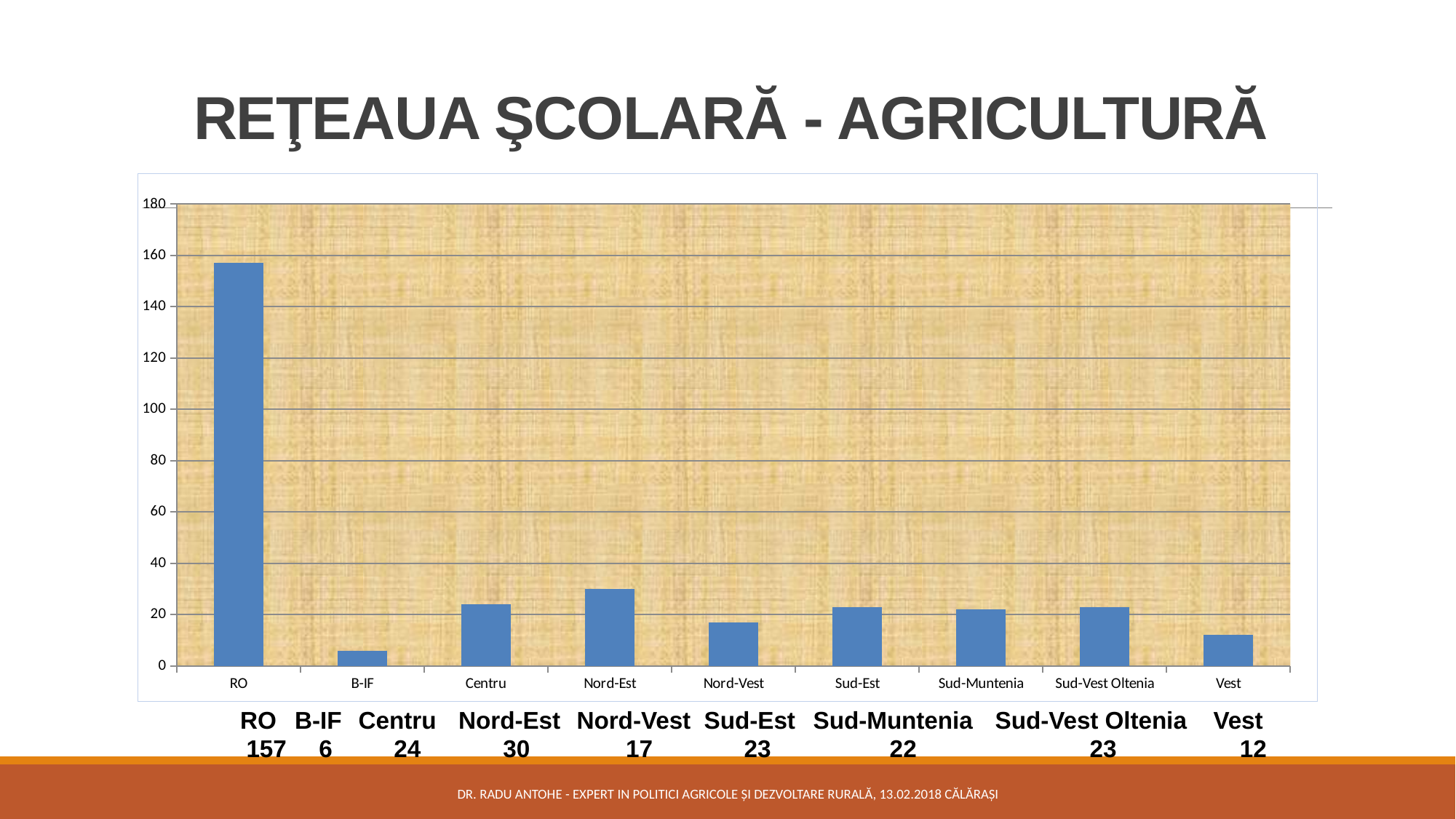
Is the value for RO greater or less than 140? greater What is the title of the slide? REŢEAUA ŞCOLARĂ - AGRICULTURĂ What is the value for Sud-Muntenia? 22 What is the value for B-IF? 6 Which category has the highest value? RO What is the difference between the values for Nord-Est and Nord-Vest? 13 What is the value for RO? 157 Which is larger, the value for Centru or the value for Vest? Centru Which category has the lowest value? B-IF How many categories are shown on the x axis? 9 What is the value for Nord-Est? 30 What kind of chart is shown on the slide? bar chart